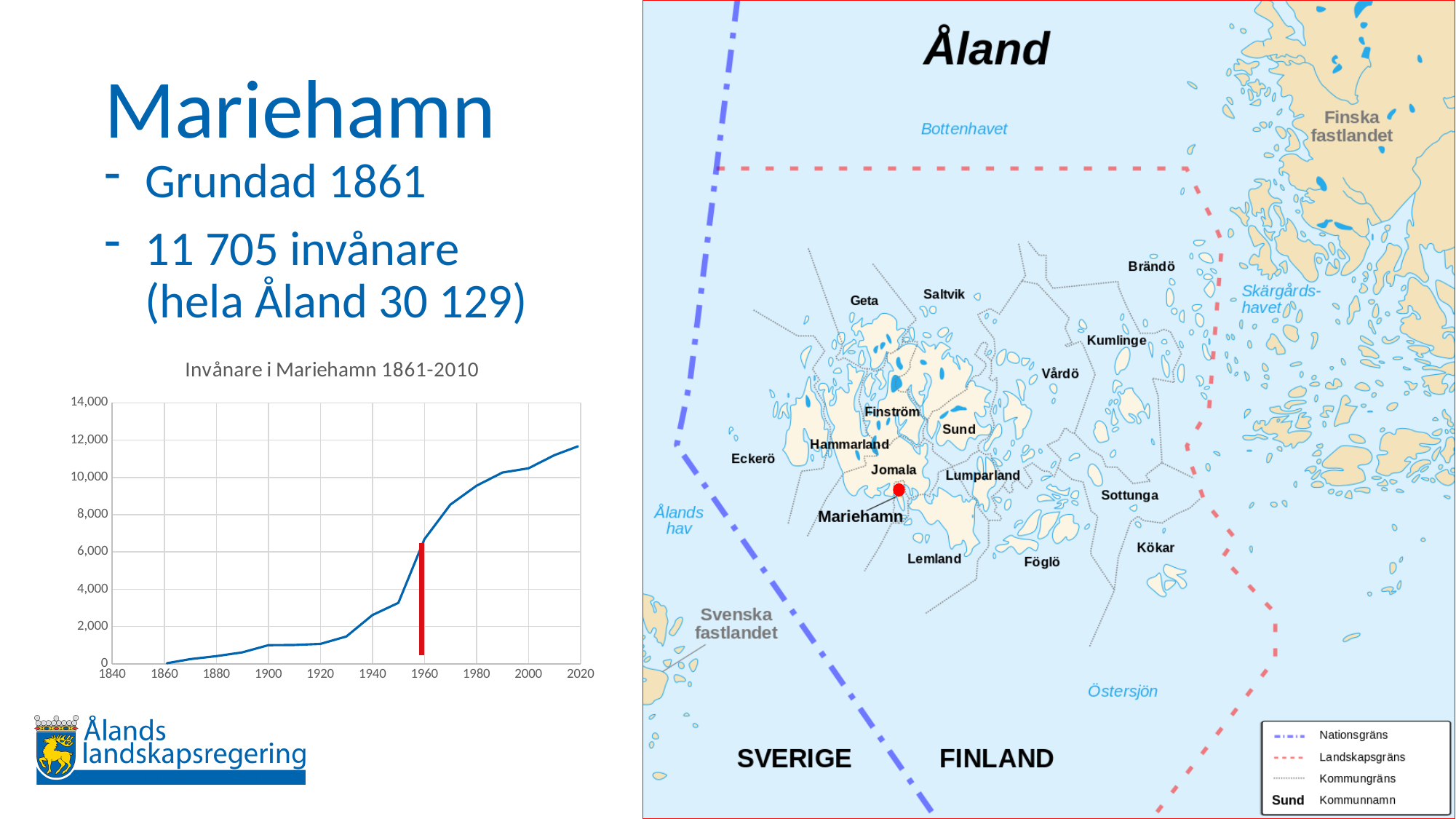
Is the value for 1920 greater or less than 4,000? less What is the highest value shown on the vertical axis of the chart? 14,000 What is the title of the chart on the slide? Invånare i Mariehamn 1861-2010 Which is larger, the value for 2000 or the value for 1960? 2000 What kind of chart is shown on the slide? line chart Is the value for 1940 greater or less than 2,000? greater Is the value for 1900 greater or less than 2,000? less Do the values in the chart rise or fall from 1861 to 2010? rise Which is larger, the value for 1900 or the value for 1940? 1940